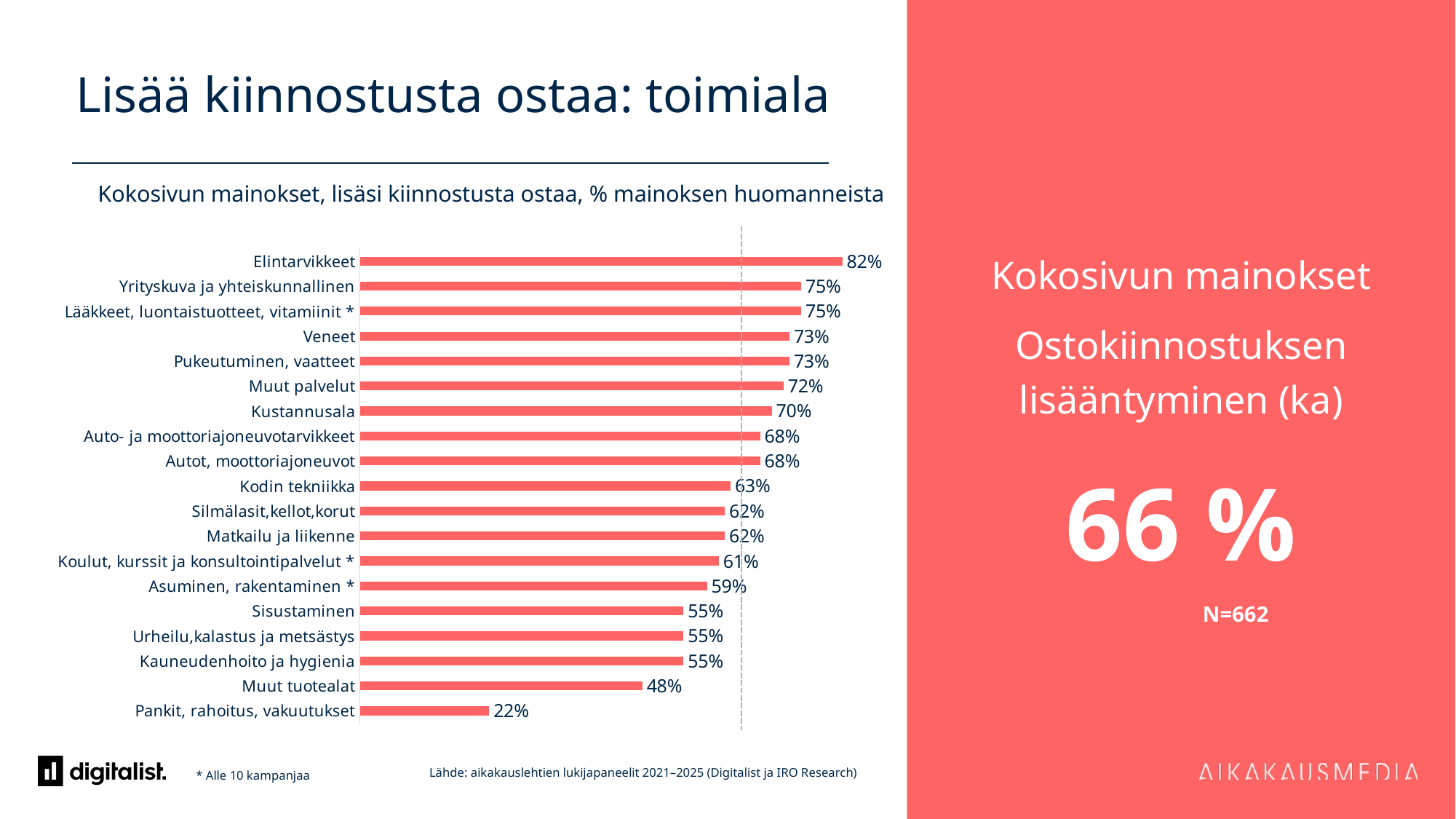
What is the difference between the values for Elintarvikkeet and Pankit, rahoitus, vakuutukset? 60% What is the value for Pankit, rahoitus, vakuutukset? 22% What is the value for Elintarvikkeet? 82% Which has a larger value, Kodin tekniikka or Muut tuotealat? Kodin tekniikka What kind of chart is shown on the slide? Bar chart What is the difference between the values for Veneet and Sisustaminen? 18% What is the average value (ka) shown in the red panel on the right? 66 % How many categories are shown in the bar chart? 19 What is the value for Muut tuotealat? 48% Which category has the lowest value? Pankit, rahoitus, vakuutukset What is the value for Kustannusala? 70% Which category has the highest value? Elintarvikkeet